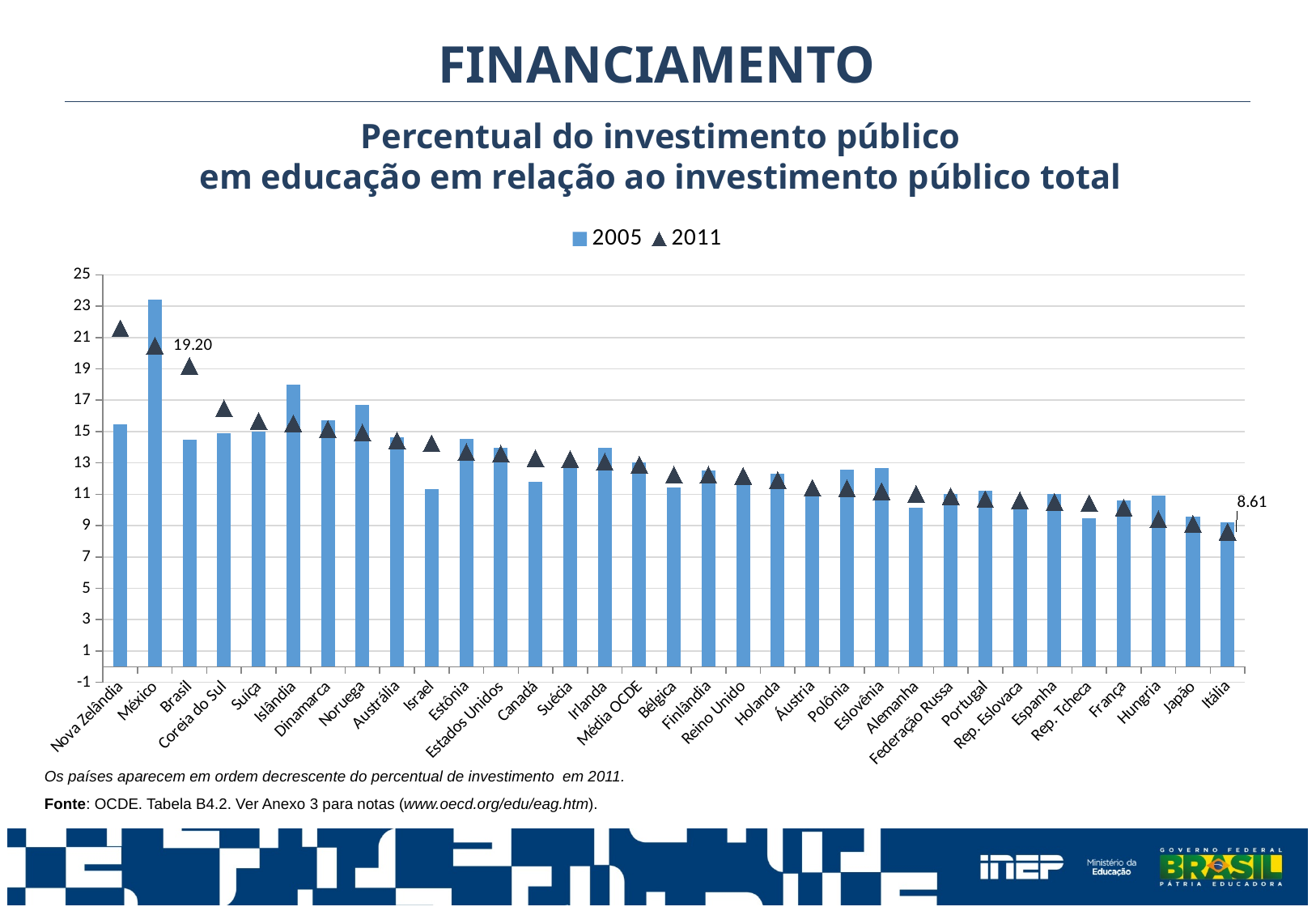
What is the 2011 value for Itália? 8.61 Is the 2005 value for Alemanha greater or less than 11? less Which series is shown with triangle markers? 2011 Which is larger for Islândia: the 2005 value or the 2011 value? 2005 What is the 2011 value for Brasil? 19.20 Which country has the highest 2005 value? México Which is larger for Brasil: the 2005 value or the 2011 value? 2011 Is the 2005 value for México greater or less than 21? greater Which country has the highest 2011 value? Nova Zelândia How many series does the legend list? 2 Is the 2005 value for Israel greater or less than 13? less Do the 2011 values rise or fall from left to right along the x axis? fall